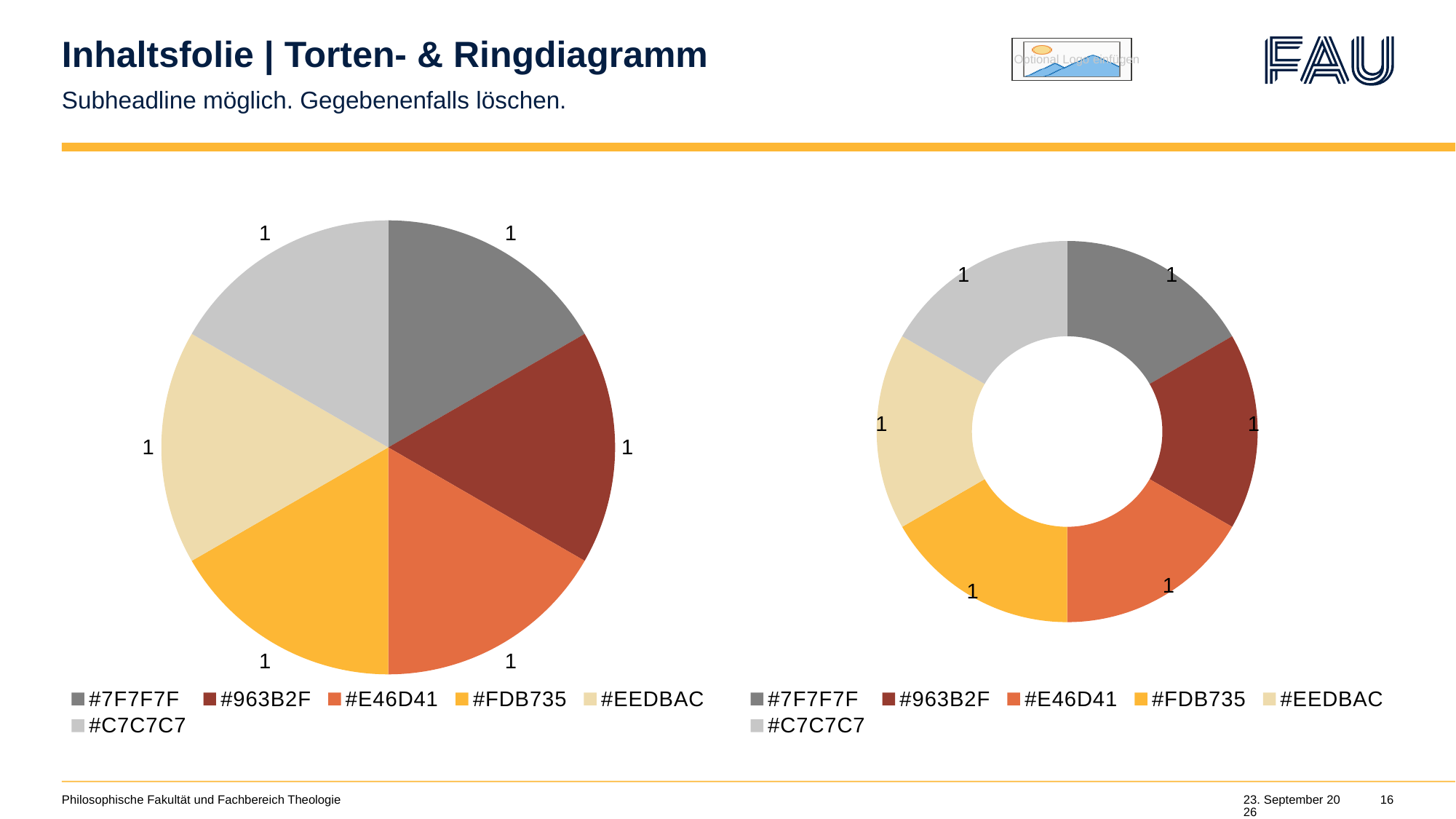
In the pie chart on the left, how many slices are there? 6 In the pie chart on the left, what is the value of the #C7C7C7 slice? 1 What kind of chart is the chart on the right side of the slide? doughnut chart In the doughnut chart on the right, what is the total of all segment values? 6 In the pie chart on the left, what is the value of the #963B2F slice? 1 In the doughnut chart on the right, what is the value of the #FDB735 segment? 1 In the pie chart on the left, which legend entry corresponds to the yellow slice? #FDB735 In the pie chart on the left, what is the difference between the values of the #7F7F7F slice and the #E46D41 slice? 0 In the pie chart on the left, what is the total of all slice values? 6 What kind of chart is the chart on the left side of the slide? pie chart In the doughnut chart on the right, how many segments are there? 6 How many entries does the legend of the doughnut chart on the right list? 6